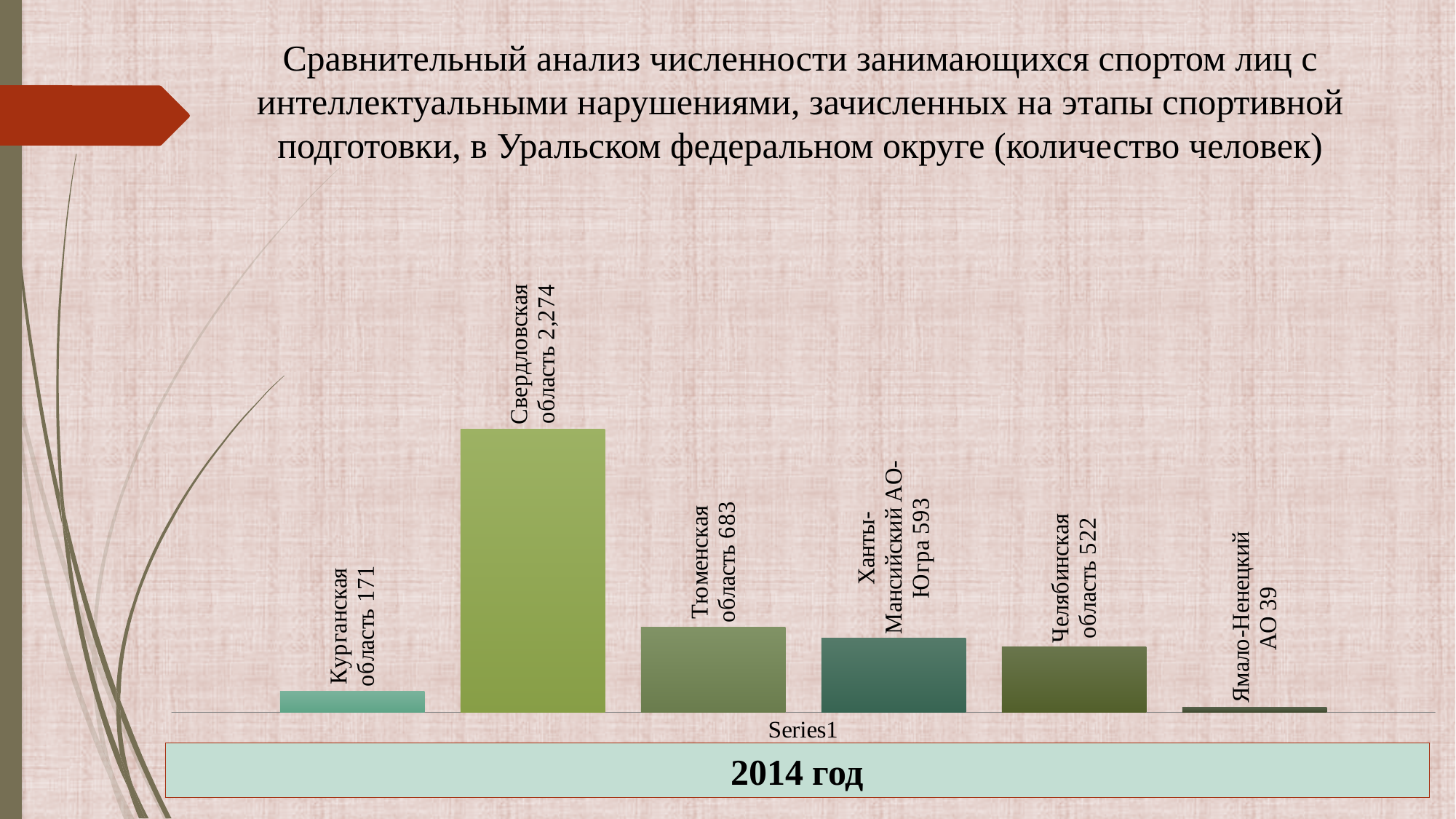
What is the value for Свердловская область? 2,274 What year is indicated in the box below the chart? 2014 год How many regions (bars) are shown in the chart? 6 What is the difference between the values for Свердловская область and Тюменская область? 1,591 What kind of chart is shown on the slide? Bar chart What is the value for Тюменская область? 683 Which region has the highest value? Свердловская область What is the value for Ханты-Мансийский АО-Югра? 593 Which is larger, the value for Ханты-Мансийский АО-Югра or the value for Курганская область? Ханты-Мансийский АО-Югра What is the difference between the values for Тюменская область and Челябинская область? 161 Which region has the lowest value? Ямало-Ненецкий АО What is the value for Ямало-Ненецкий АО? 39